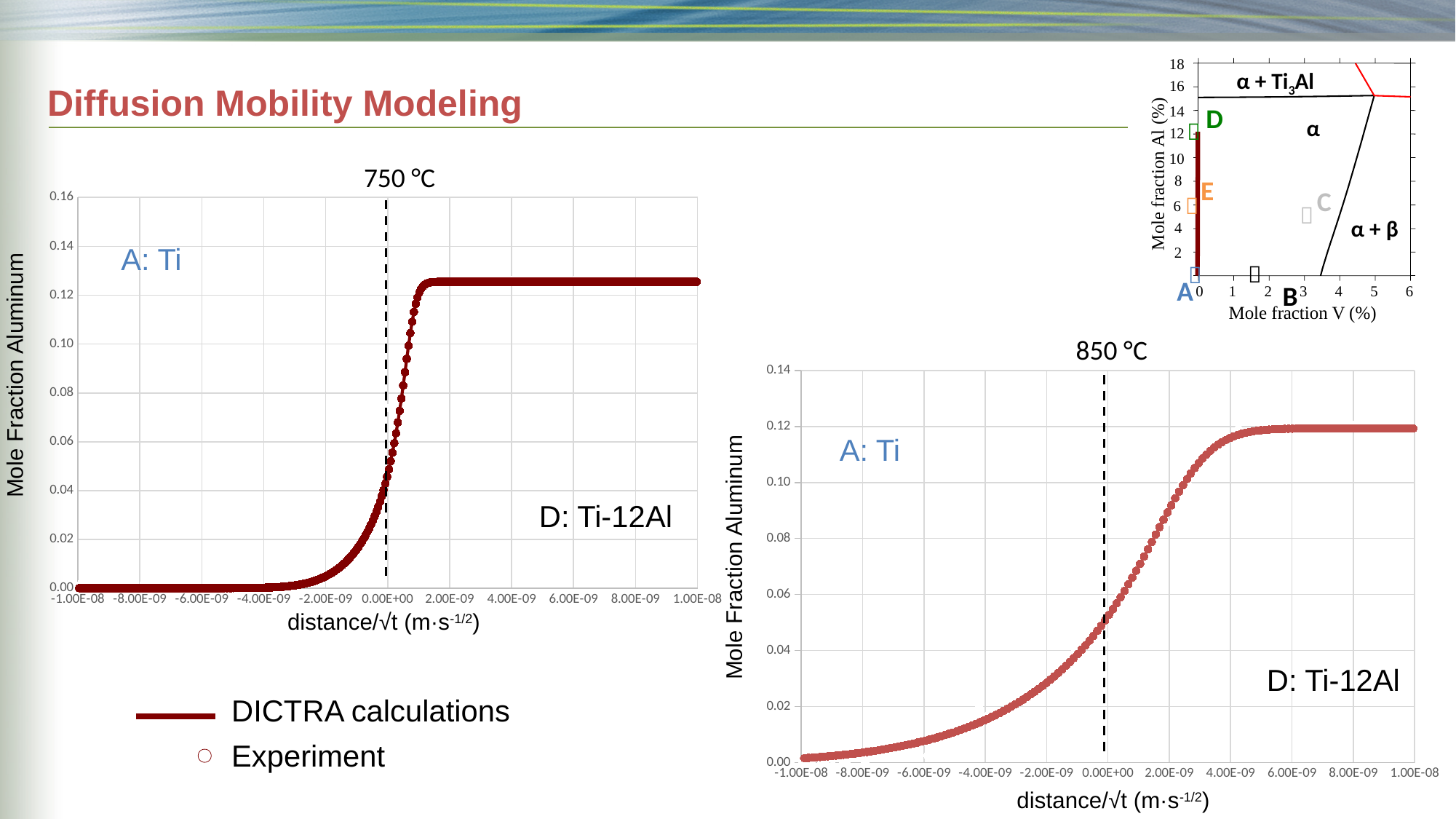
In the 850 °C chart, is the value at distance/√t = -6.00E-09 greater or less than 0.02? less In the 750 °C chart, is the value at distance/√t = -4.00E-09 greater or less than 0.02? less What kind of chart is the 750 °C chart on the left? line chart What is the x-axis label of the small phase diagram in the top right? Mole fraction V (%) In the 850 °C chart, is the value at distance/√t = 4.00E-09 greater or less than 0.10? greater In the 750 °C chart, do the values rise or fall as distance/√t increases along the x axis? rise In the 750 °C chart, which is larger: the value at distance/√t = 6.00E-09 or at -6.00E-09? 6.00E-09 In the 850 °C chart, do the values rise or fall as distance/√t increases along the x axis? rise How many entries does the legend below the 750 °C chart list? 2 What is the highest tick value on the y axis of the 750 °C chart? 0.16 In the 850 °C chart, which is larger: the value at distance/√t = 4.00E-09 or at -4.00E-09? 4.00E-09